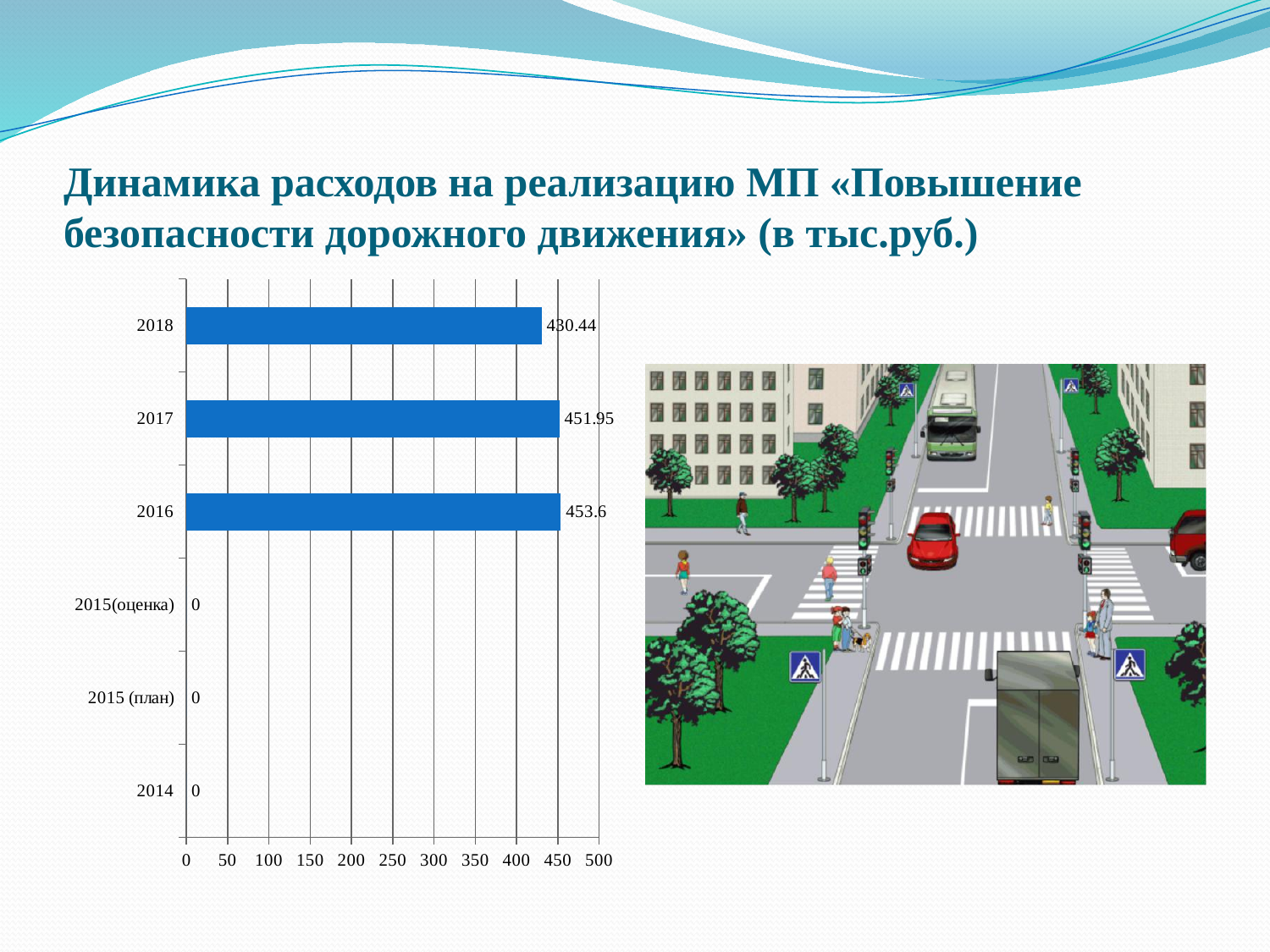
Do the values rise or fall from 2016 to 2018? fall Is the value for 2018 greater or less than 400? greater Which is larger, the value for 2017 or the value for 2018? 2017 How many categories are shown on the chart? 6 What is the value for 2016? 453.6 Which category has the highest value? 2016 What is the value for 2017? 451.95 What kind of chart is shown on the slide? bar chart What is the difference between the values for 2016 and 2018? 23.16 What is the value for 2014? 0 What is the value for 2018? 430.44 What is the difference between the values for 2017 and 2018? 21.51